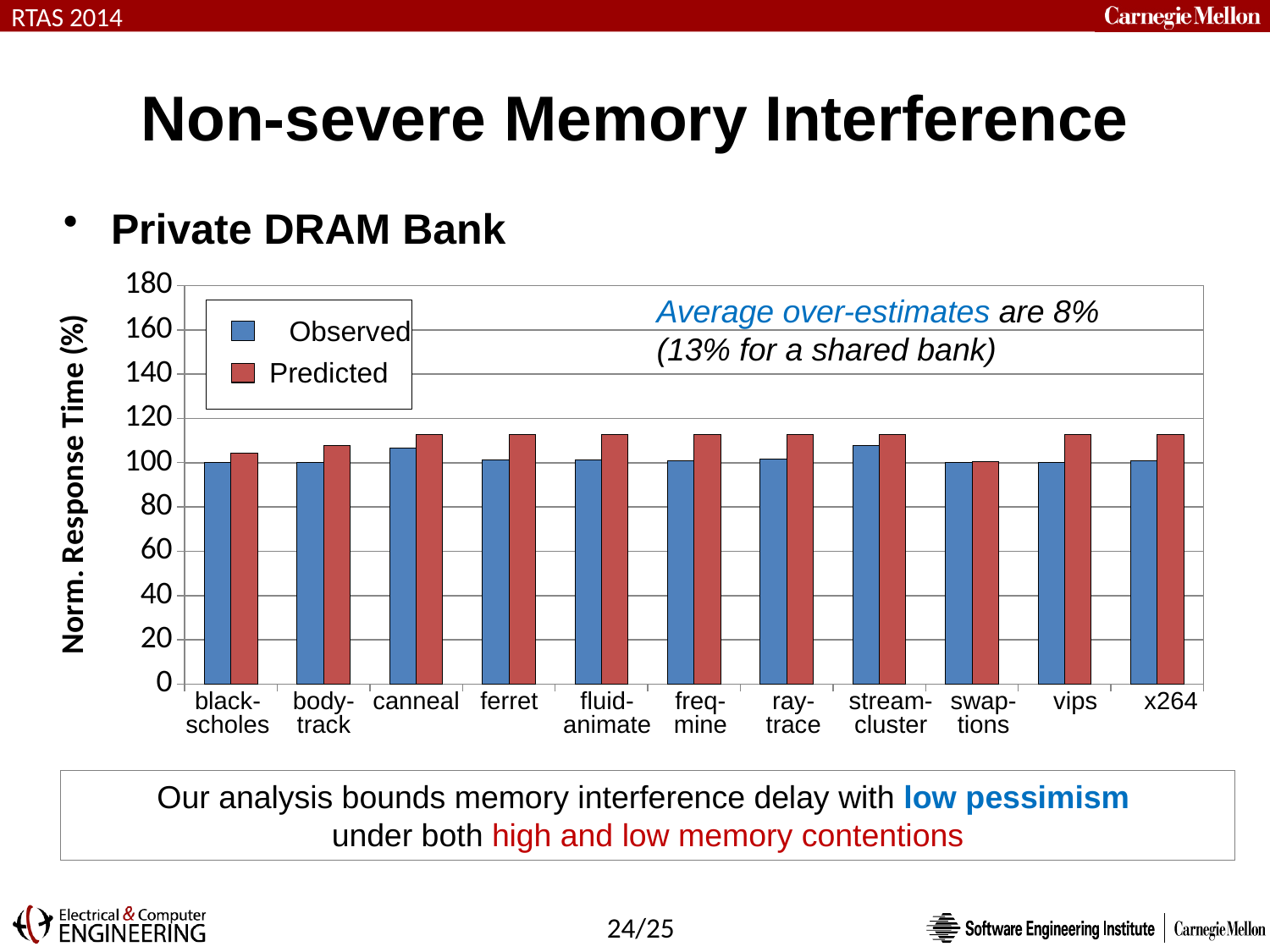
How many series does the chart legend list? 2 Is the Predicted value for canneal greater or less than 100? greater Is the Observed value for blackscholes greater or less than 120? less For bodytrack, which is larger: the Observed value or the Predicted value? Predicted Is the Observed value for swaptions greater or less than 140? less What kind of chart is shown on the slide? bar chart For canneal, which is larger: the Observed value or the Predicted value? Predicted What is the label of the chart's y axis? Norm. Response Time (%) For vips, which is larger: the Observed value or the Predicted value? Predicted How many benchmark categories are shown on the x axis of the chart? 11 Which colour represents the Predicted series in the chart legend? red